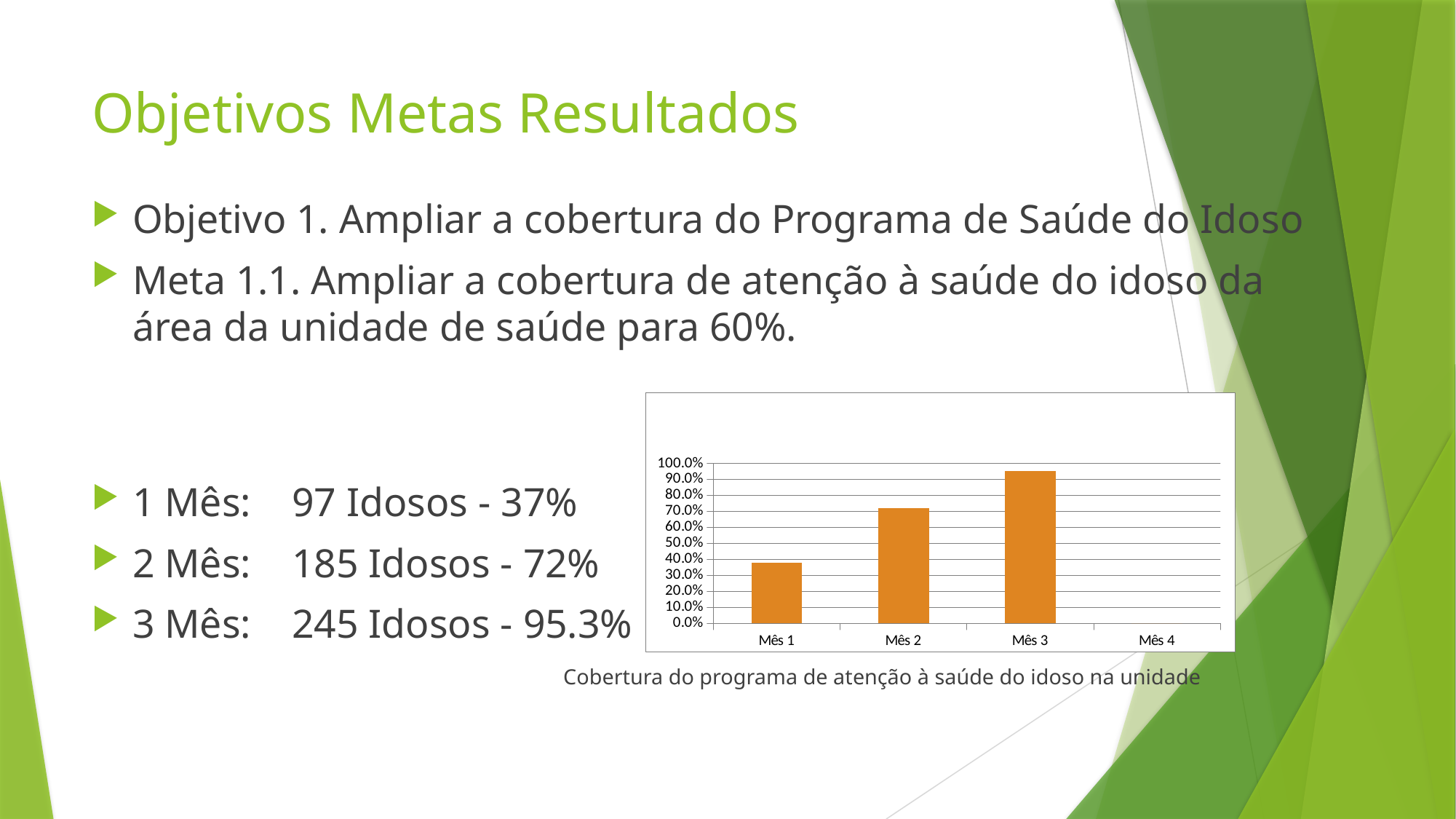
How many categories are shown on the x axis of the chart? 4 Is the value for Mês 1 greater or less than 40.0%? less Do the bar values rise or fall from Mês 1 to Mês 3? rise Is the value for Mês 1 greater or less than 30.0%? greater What kind of chart is shown on the slide? bar chart Is the value for Mês 2 greater or less than 80.0%? less What is the caption written below the chart? Cobertura do programa de atenção à saúde do idoso na unidade Which is larger, the value for Mês 1 or the value for Mês 2? Mês 2 What colour are the bars in the chart? orange Which month has the tallest bar in the chart? Mês 3